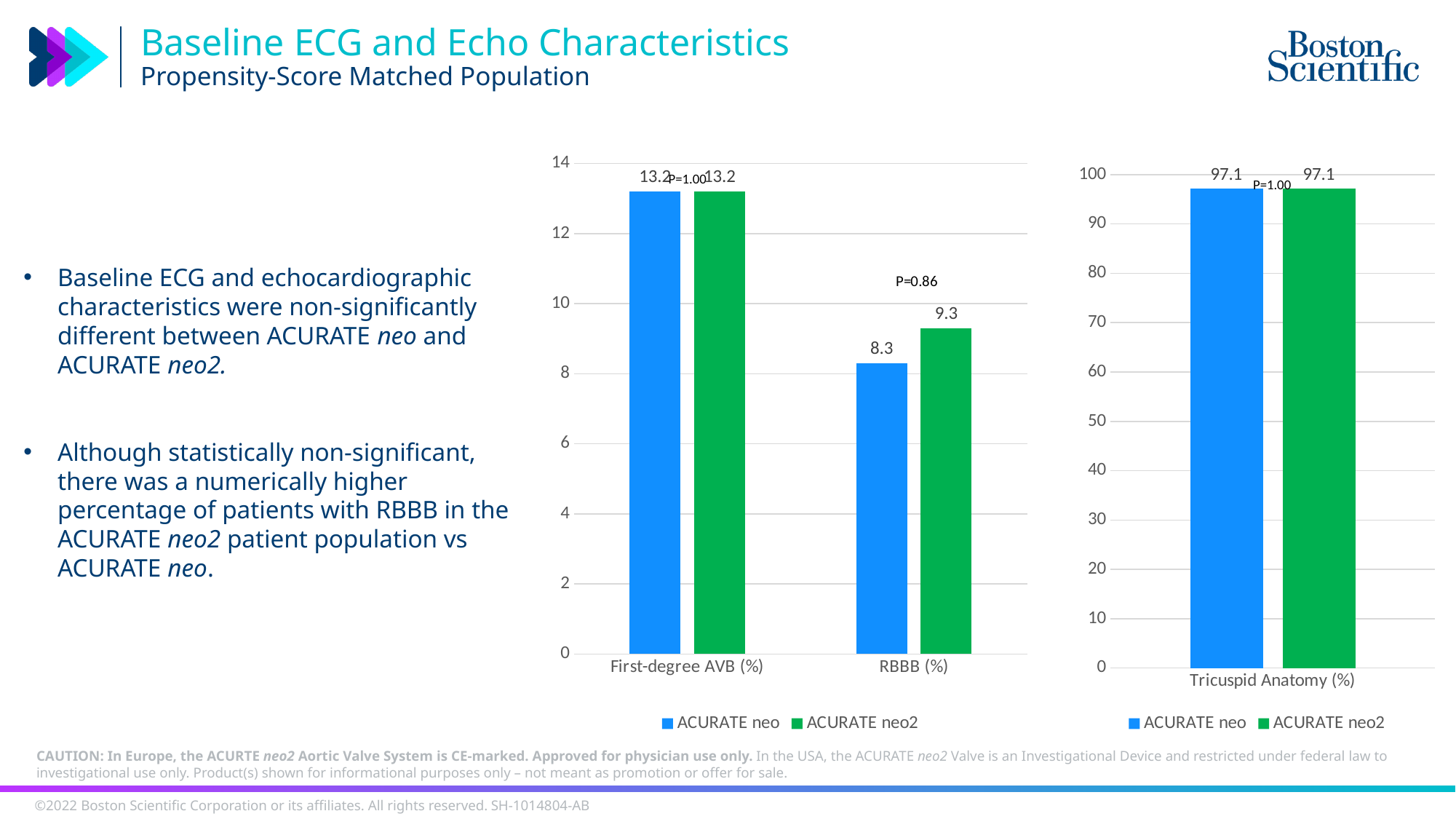
In the left chart, what is the value for ACURATE neo for RBBB (%)? 8.3 In the left chart, is the value for ACURATE neo for RBBB (%) greater or less than 10? less In the left chart, what is the difference between the ACURATE neo2 and ACURATE neo values for RBBB (%)? 1.0 What kind of chart is the right chart? Bar chart In the right chart, is the value for ACURATE neo for Tricuspid Anatomy (%) greater or less than 90? greater In the right chart, what is the value for ACURATE neo2 for Tricuspid Anatomy (%)? 97.1 In the left chart, which series has the larger value for RBBB (%), ACURATE neo or ACURATE neo2? ACURATE neo2 In the left chart, what is the value for ACURATE neo for First-degree AVB (%)? 13.2 How many categories are shown on the x axis of the left chart? 2 How many series does the legend of the right chart list? 2 In the left chart, which category has the lowest value for ACURATE neo? RBBB (%) In the left chart, what is the value for ACURATE neo2 for RBBB (%)? 9.3